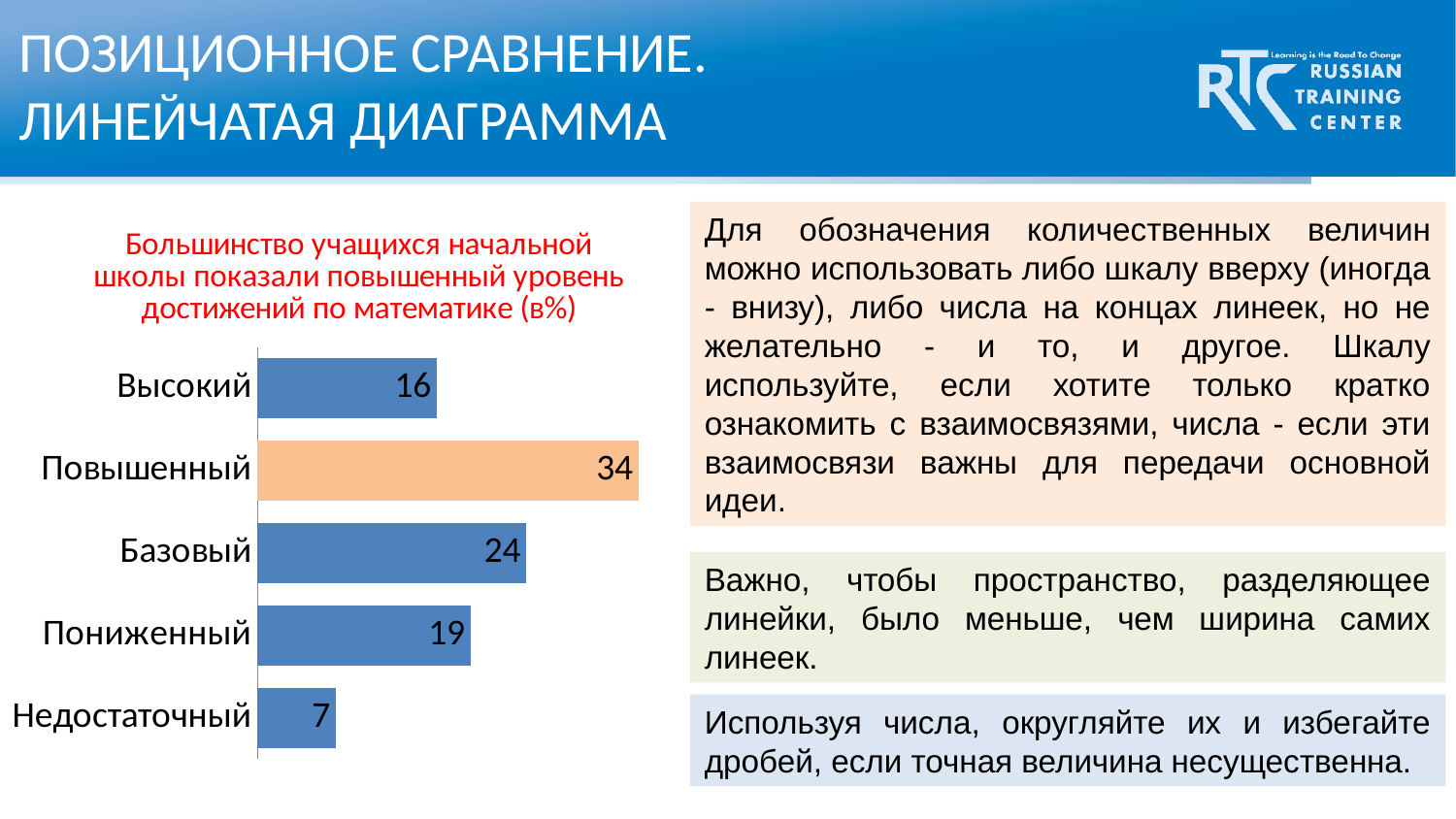
What is the value for Недостаточный? 7 Which category has the lowest value? Недостаточный What is the value for Базовый? 24 What is the value for Высокий? 16 What is the value for Повышенный? 34 How many categories are shown in the chart? 5 What is the difference between the values for Повышенный and Базовый? 10 Which is larger, the value for Пониженный or the value for Высокий? Пониженный Which category has the highest value? Повышенный Which bar is highlighted in a different colour (orange) from the others? Повышенный What kind of chart is shown on the slide? Bar chart What is the total of the values for Высокий and Повышенный? 50